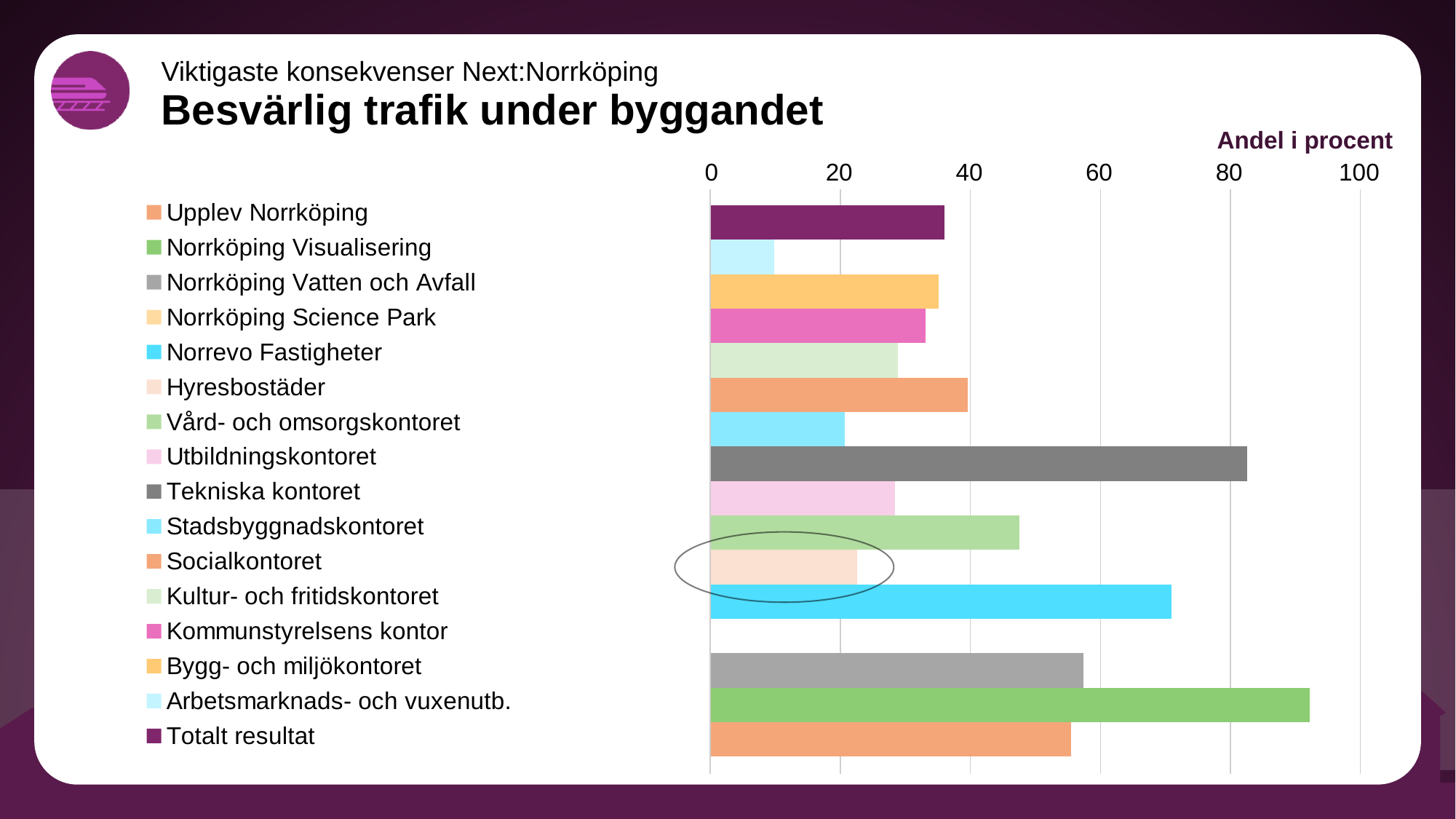
What is the main title of the slide above the chart? Besvärlig trafik under byggandet Which is larger, the value for Norrköping Visualisering or the value for Upplev Norrköping? Norrköping Visualisering Is the value for Arbetsmarknads- och vuxenutb. greater or less than 20? less How many entries does the chart's legend list? 16 Which is larger, the value for Tekniska kontoret or the value for Norrevo Fastigheter? Tekniska kontoret Is the value for Norrevo Fastigheter greater or less than 60? greater What kind of chart is shown on the slide? bar chart What label is shown above the horizontal axis of the chart? Andel i procent Is the value for Hyresbostäder greater or less than 40? less Which entry has the longest bar in the chart? Norrköping Visualisering